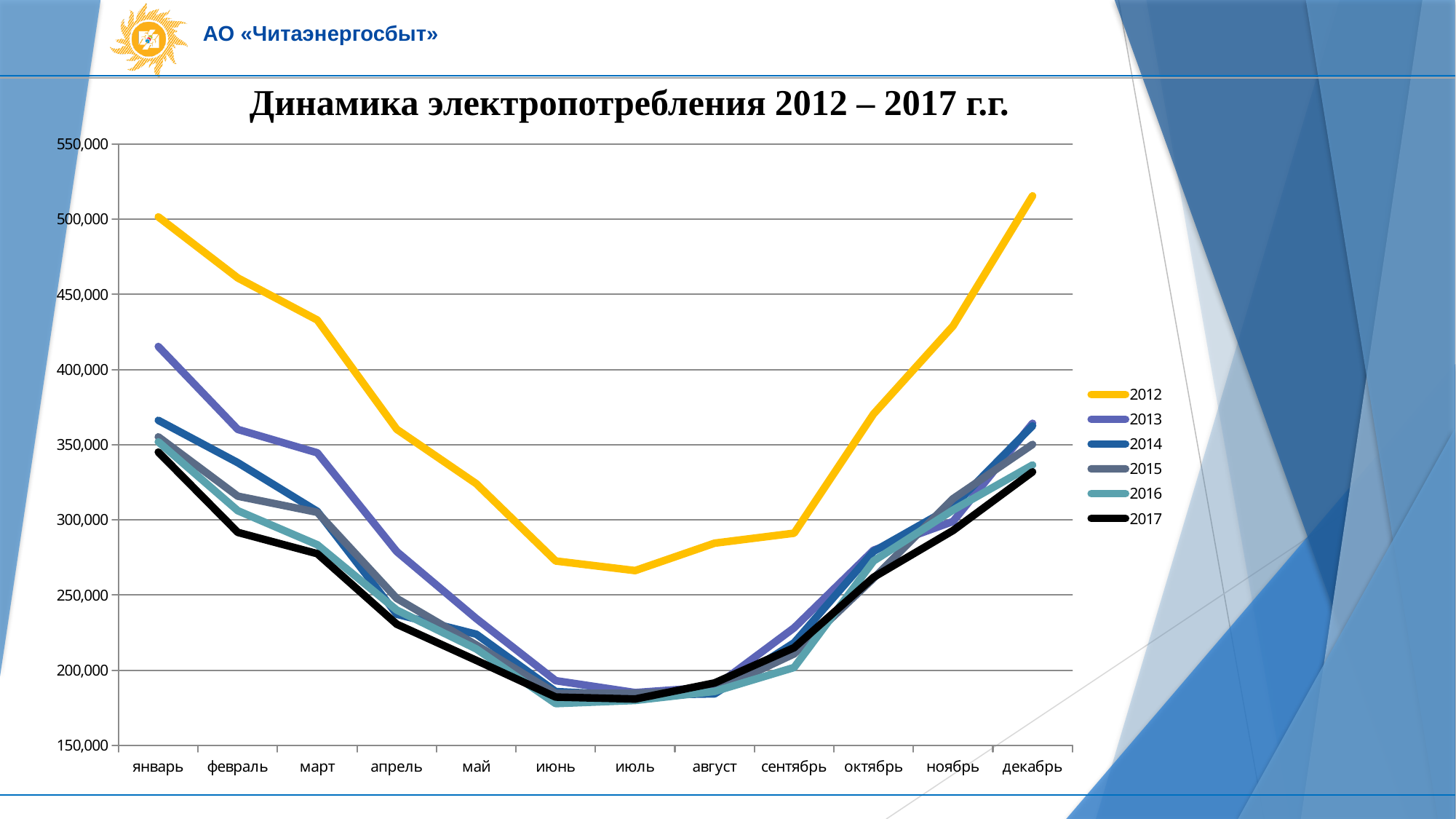
Is the value for 2017 in июль greater or less than 200,000? less Which series is drawn in yellow? 2012 From январь to июль, does the 2012 series rise or fall? fall How many series does the legend list? 6 Which is larger in январь, the value for 2012 or the value for 2013? 2012 Is the value for 2012 in январь greater or less than 450,000? greater What kind of chart is shown on the slide? line chart How many months are shown along the x axis? 12 In which month does the 2012 series reach its lowest value? июль In which month does the 2012 series reach its highest value? декабрь What is the title of the chart? Динамика электропотребления 2012 – 2017 г.г. Which series has the highest value in январь? 2012